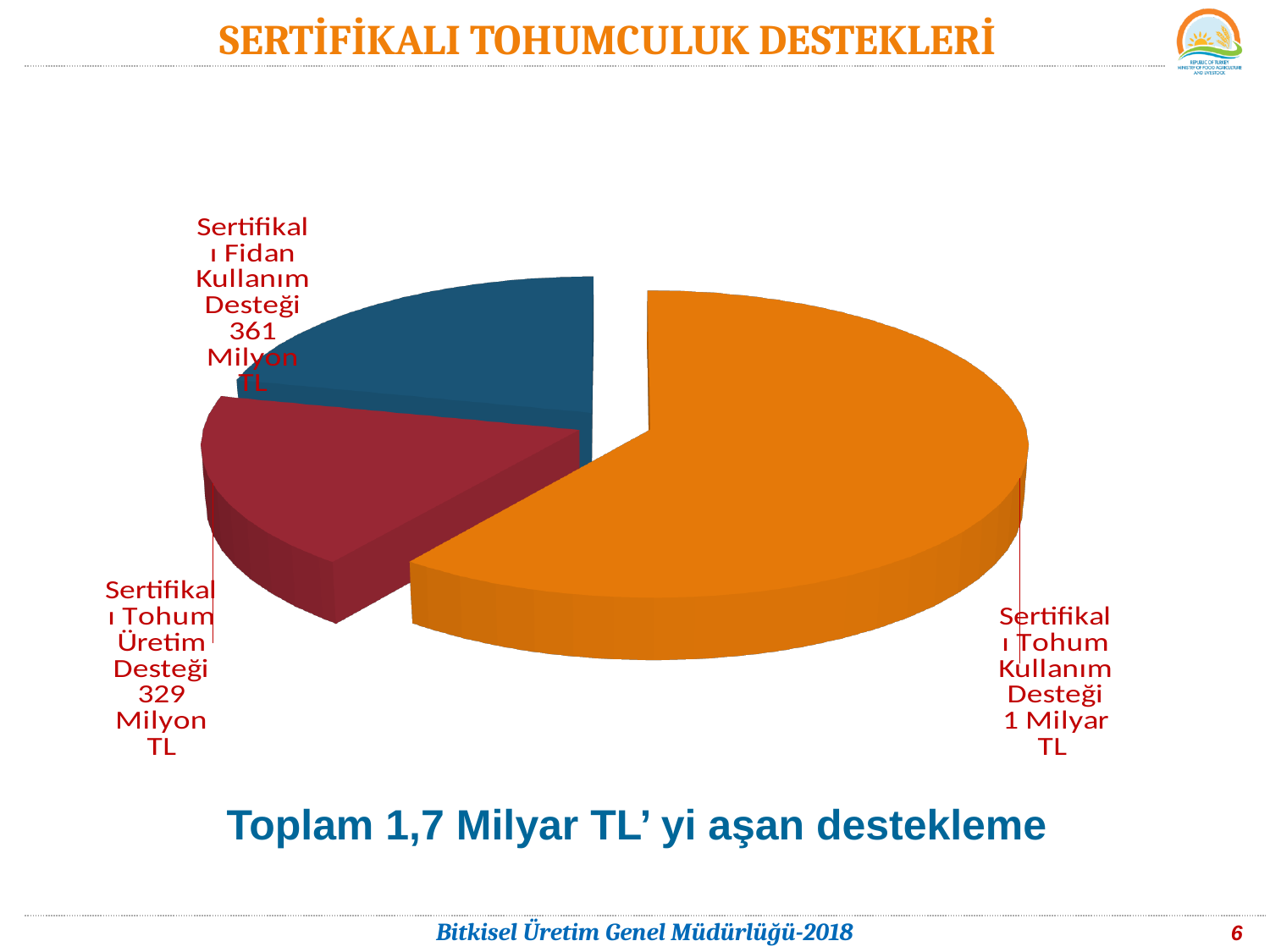
Which category has the smallest slice of the pie? Sertifikalı Tohum Üretim Desteği Which category is represented by the orange slice? Sertifikalı Tohum Kullanım Desteği What is the title of the slide containing the chart? SERTİFİKALI TOHUMCULUK DESTEKLERİ What is the difference between the values for Sertifikalı Fidan Kullanım Desteği and Sertifikalı Tohum Üretim Desteği? 32 Milyon TL What is the value shown for Sertifikalı Fidan Kullanım Desteği? 361 Milyon TL Which is larger, the value for Sertifikalı Fidan Kullanım Desteği or for Sertifikalı Tohum Üretim Desteği? Sertifikalı Fidan Kullanım Desteği How many slices does the pie chart have? 3 Which category has the largest slice of the pie? Sertifikalı Tohum Kullanım Desteği What is the value shown for Sertifikalı Tohum Üretim Desteği? 329 Milyon TL What kind of chart is shown on the slide? Pie chart What is the value shown for Sertifikalı Tohum Kullanım Desteği? 1 Milyar TL